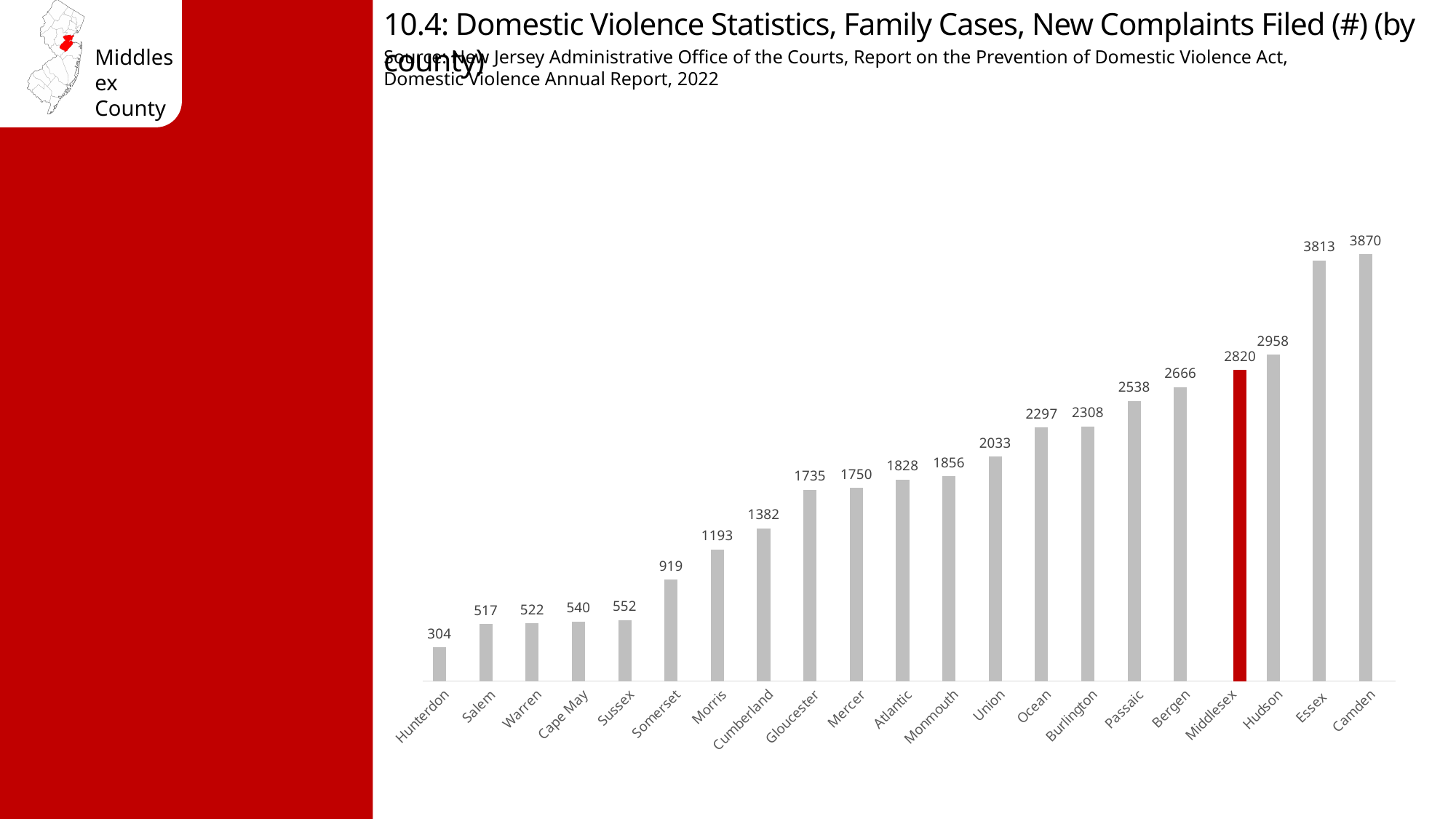
Do the values rise or fall moving from left to right along the x axis? Rise What kind of chart is shown on the slide? Bar chart Which county has the lowest number of new complaints filed? Hunterdon What is the value shown for Gloucester? 1735 What is the number of new domestic violence complaints filed for Middlesex? 2820 What is the value shown for Hunterdon? 304 What is the difference between the values for Camden and Essex? 57 What is the difference between the values for Hudson and Middlesex? 138 Which has a larger value, Bergen or Passaic? Bergen Which county has the highest number of new complaints filed? Camden How many counties are shown in the chart? 21 Which county's bar is highlighted in red? Middlesex